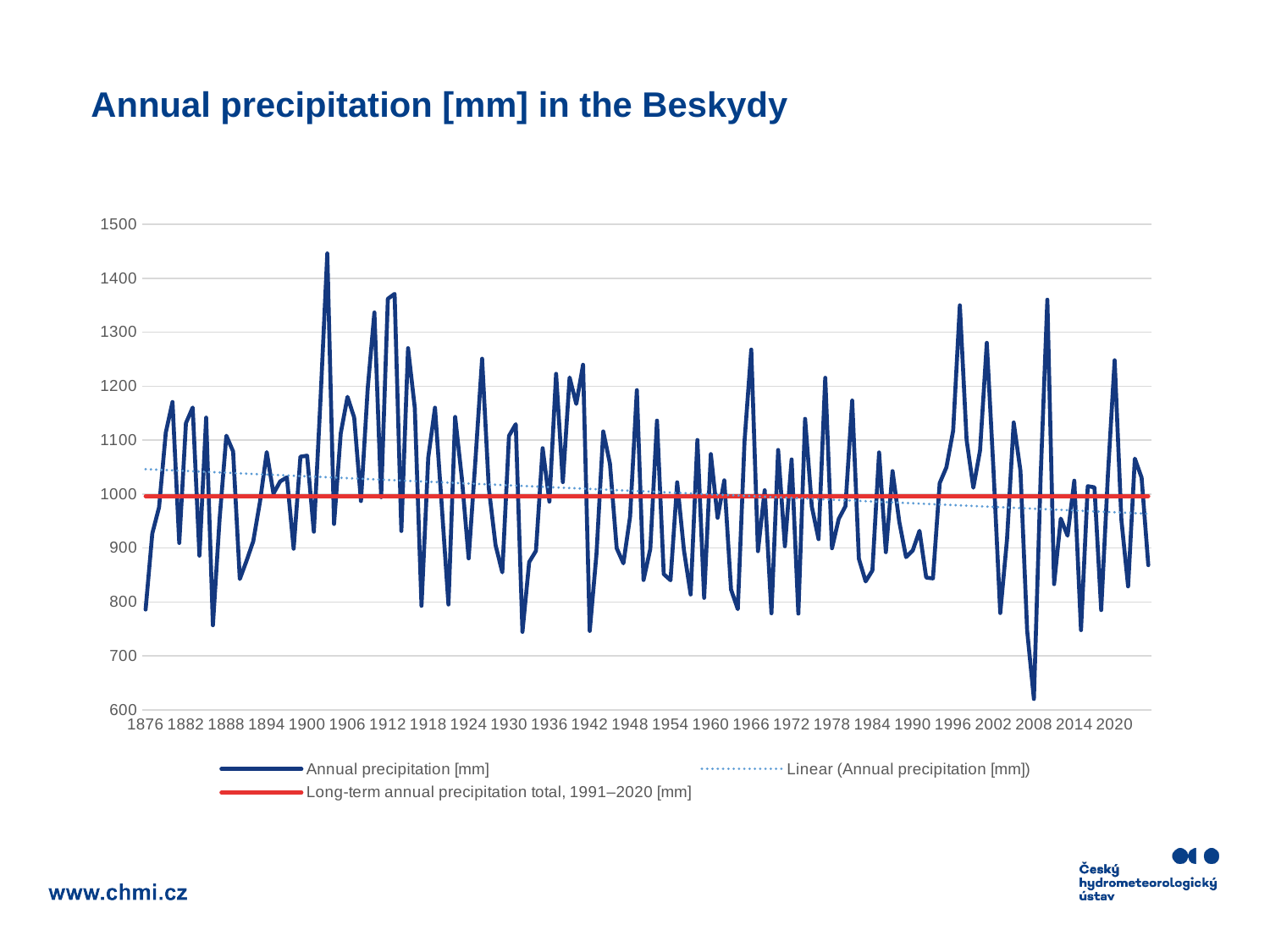
Is the annual precipitation value for 2008 greater or less than 1300? less Which period does the long-term annual precipitation total in the legend refer to? 1991–2020 What is the title of the chart? Annual precipitation [mm] in the Beskydy What is the last year shown on the x axis? 2020 What kind of chart is shown on the slide? Line chart Is the highest value of the annual precipitation series greater or less than 1400? greater Is the annual precipitation value for 1942 greater or less than 800? less How many series does the legend list? 3 What is the first year shown on the x axis? 1876 Does the dotted linear trend line rise or fall from left to right across the x axis? fall